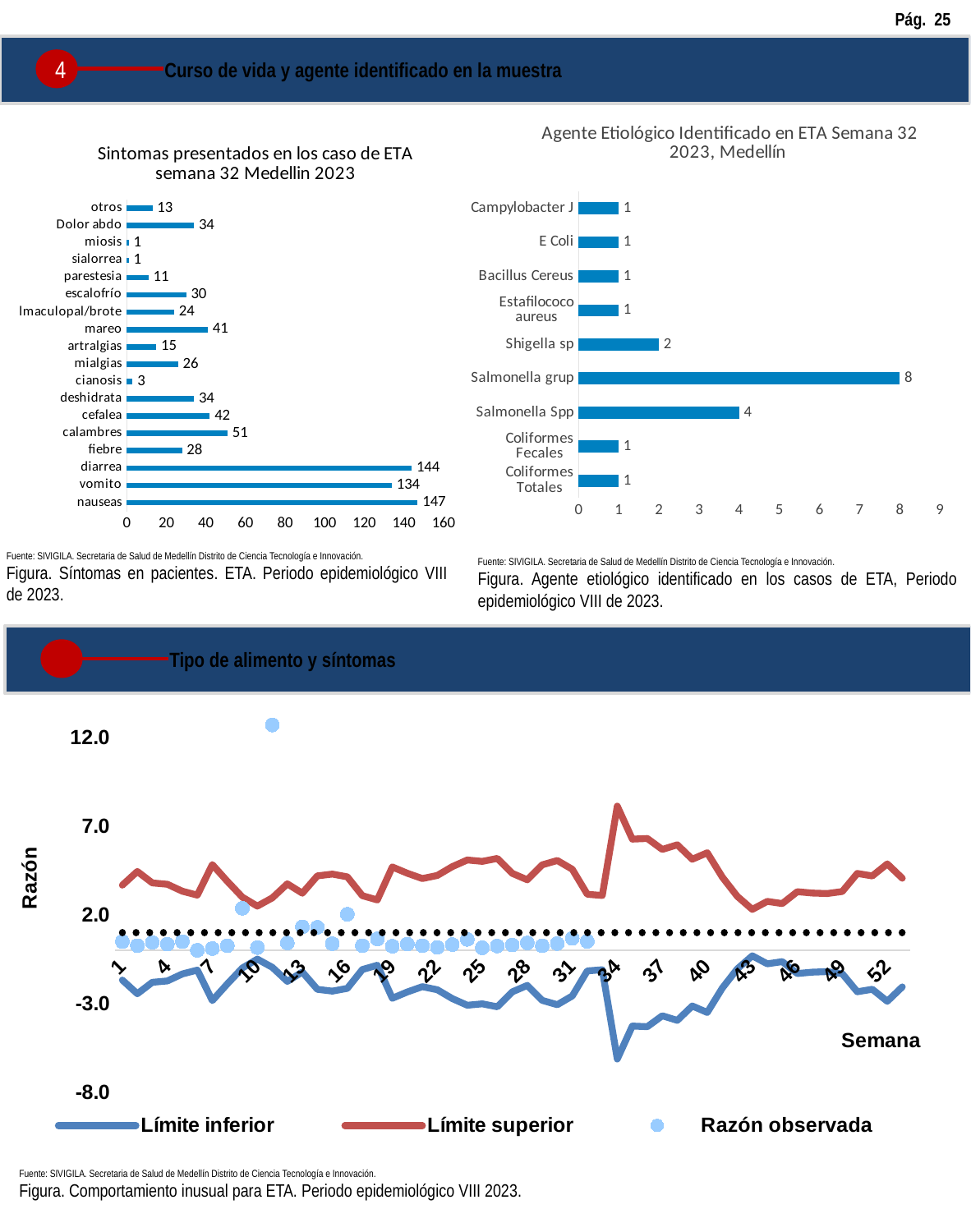
In the chart 'Agente Etiológico Identificado en ETA Semana 32 2023, Medellín', which agent has the highest value? Salmonella grup What kind of chart is the 'Agente Etiológico Identificado en ETA Semana 32 2023, Medellín' chart? bar chart In the chart 'Sintomas presentados en los caso de ETA semana 32 Medellin 2023', how many symptom categories are shown? 18 In the chart at the bottom of the slide (Comportamiento inusual para ETA), how many series does the legend list? 3 In the chart 'Agente Etiológico Identificado en ETA Semana 32 2023, Medellín', how many agent categories are shown? 9 In the chart 'Sintomas presentados en los caso de ETA semana 32 Medellin 2023', what is the value for nauseas? 147 In the chart 'Agente Etiológico Identificado en ETA Semana 32 2023, Medellín', what is the value for Salmonella Spp? 4 In the chart 'Sintomas presentados en los caso de ETA semana 32 Medellin 2023', which symptom has the highest value? nauseas In the chart 'Sintomas presentados en los caso de ETA semana 32 Medellin 2023', what is the difference between the values for diarrea and vomito? 10 In the chart 'Sintomas presentados en los caso de ETA semana 32 Medellin 2023', what is the value for escalofrío? 30 In the chart 'Agente Etiológico Identificado en ETA Semana 32 2023, Medellín', what is the difference between Salmonella grup and Shigella sp? 6 In the chart 'Sintomas presentados en los caso de ETA semana 32 Medellin 2023', which is larger, calambres or cefalea? calambres